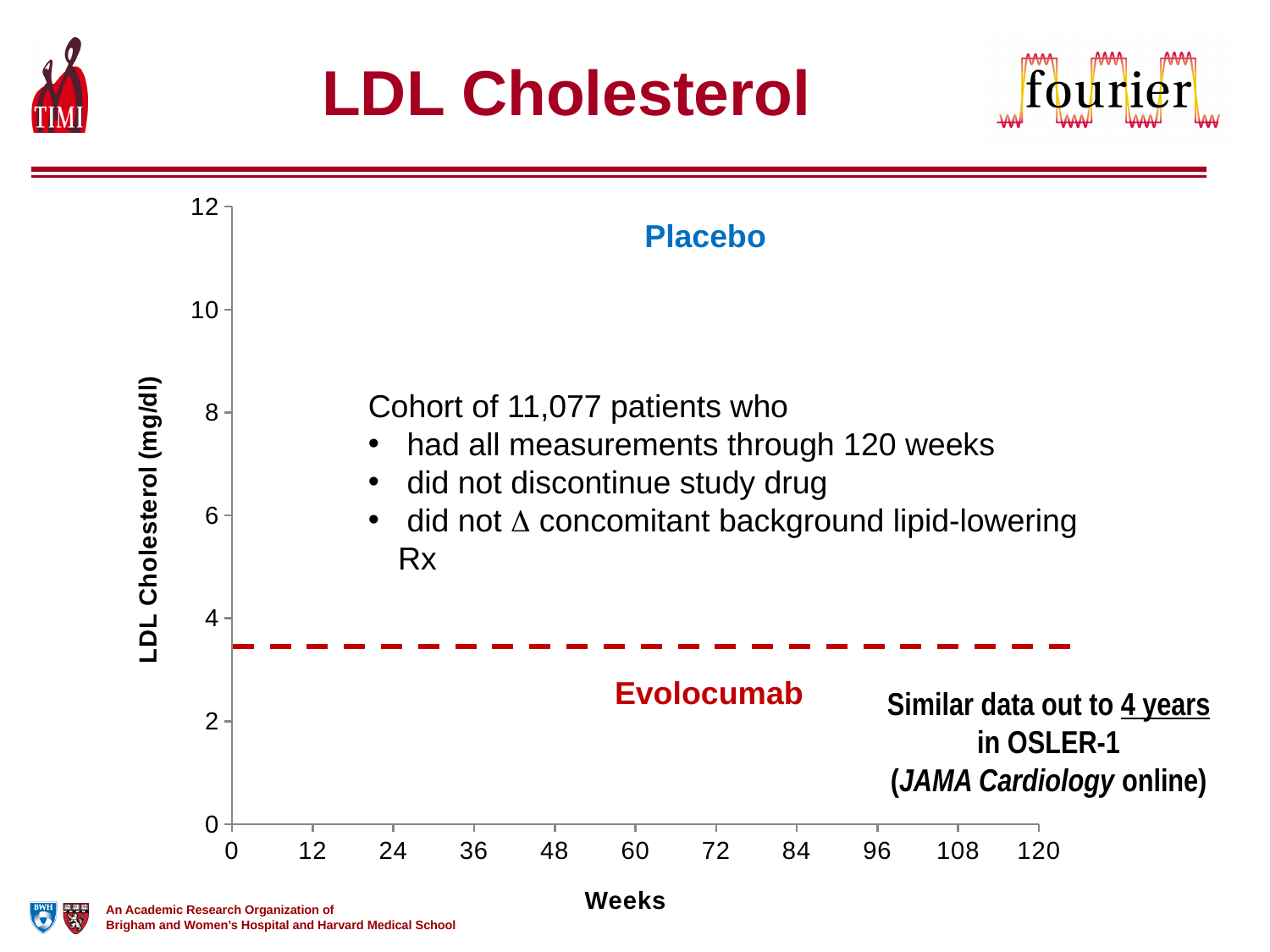
What kind of chart is shown on the slide? line chart Is the Evolocumab value at week 60 greater or less than 4 mg/dl? less Does the Evolocumab line rise, fall, or stay flat from week 0 to week 120? stays flat Is the Evolocumab value at week 120 greater or less than 2 mg/dl? greater What is the last week value labelled on the x axis? 120 How many tick marks are labelled on the Weeks axis? 11 Is the Evolocumab value at week 12 greater or less than 6 mg/dl? less What is the title of the y axis? LDL Cholesterol (mg/dl) What is the highest value labelled on the y axis? 12 What is the title of the x axis? Weeks